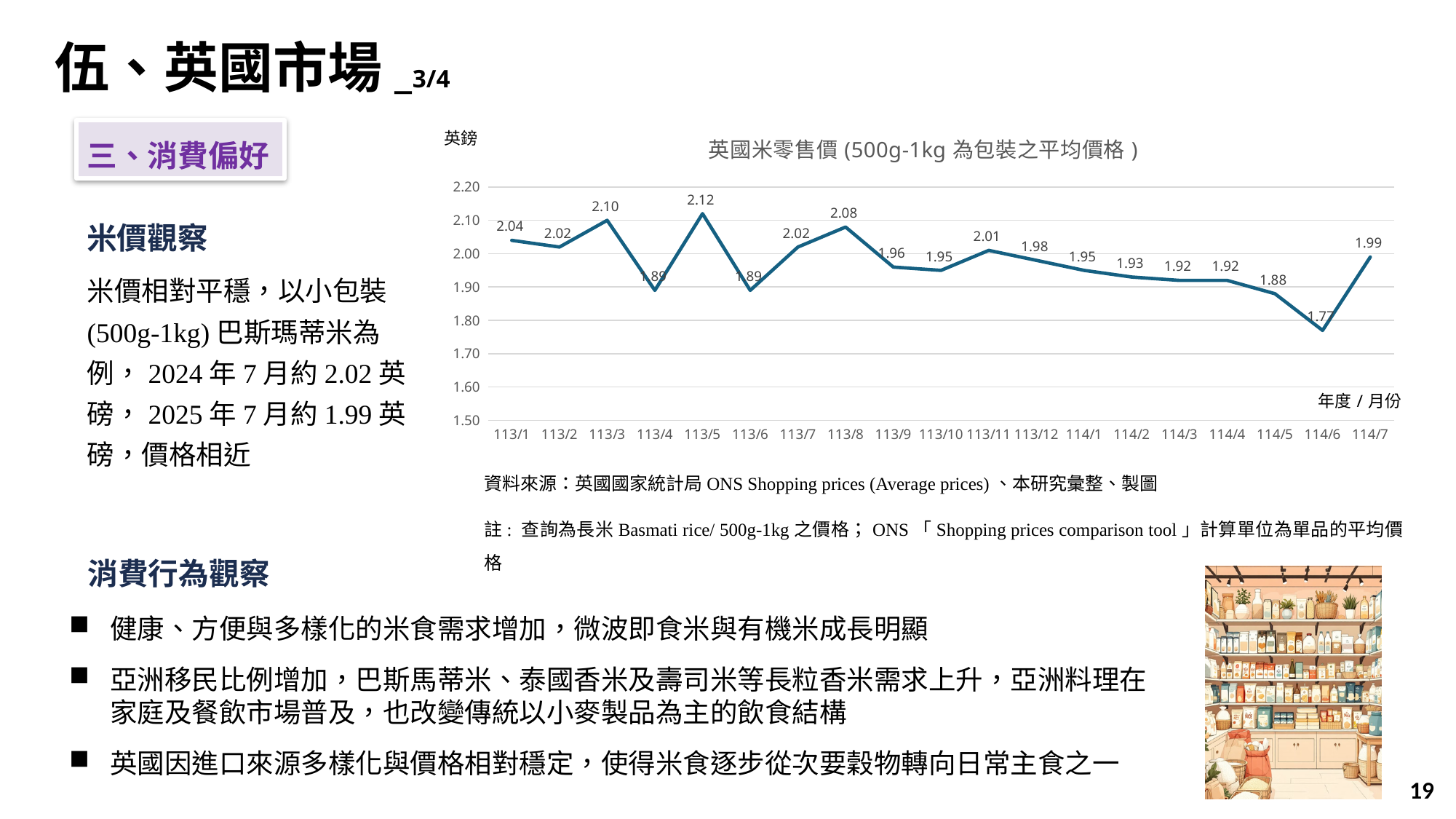
What is the title of the chart? 英國米零售價 (500g-1kg 為包裝之平均價格 ) Which month has the highest value? 113/5 What is the difference between the values for 113/5 and 114/6? 0.35 What is the value for 113/5? 2.12 What unit is shown on the y axis of the chart? 英鎊 Which is larger, the value for 113/3 or the value for 113/8? 113/3 What is the value for 114/6? 1.77 Which month has the lowest value? 114/6 What is the value for 114/7? 1.99 What type of chart is shown on the slide? line chart How many data points are plotted on the chart? 19 What is the value for 113/7? 2.02